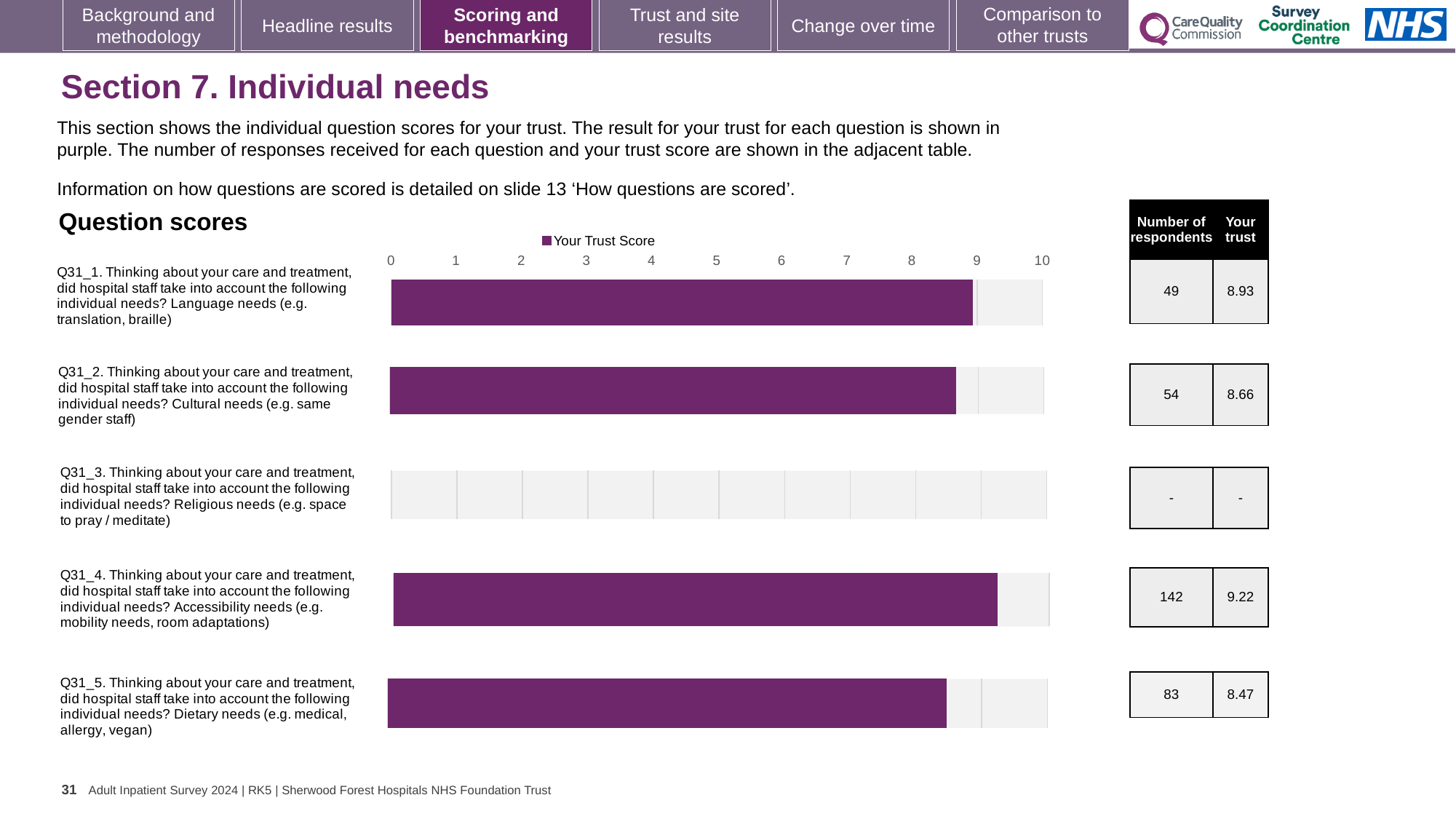
What is the trust score for Q31_1 (Language needs)? 8.93 Which has a higher trust score, Q31_1 (Language needs) or Q31_2 (Cultural needs)? Q31_1 (Language needs) What series name is shown in the chart legend? Your Trust Score What type of chart is used to show the question scores? Bar chart How many respondents answered Q31_2 (Cultural needs)? 54 Among the questions with a plotted score, which has the lowest trust score? Q31_5 (Dietary needs) What is the trust score for Q31_4 (Accessibility needs)? 9.22 What is the trust score for Q31_5 (Dietary needs)? 8.47 What is the difference between the trust scores for Q31_4 and Q31_5? 0.75 Which question has the highest trust score? Q31_4 (Accessibility needs) Is the trust score for Q31_2 (Cultural needs) greater or less than 9? less How many questions are listed in the chart? 5